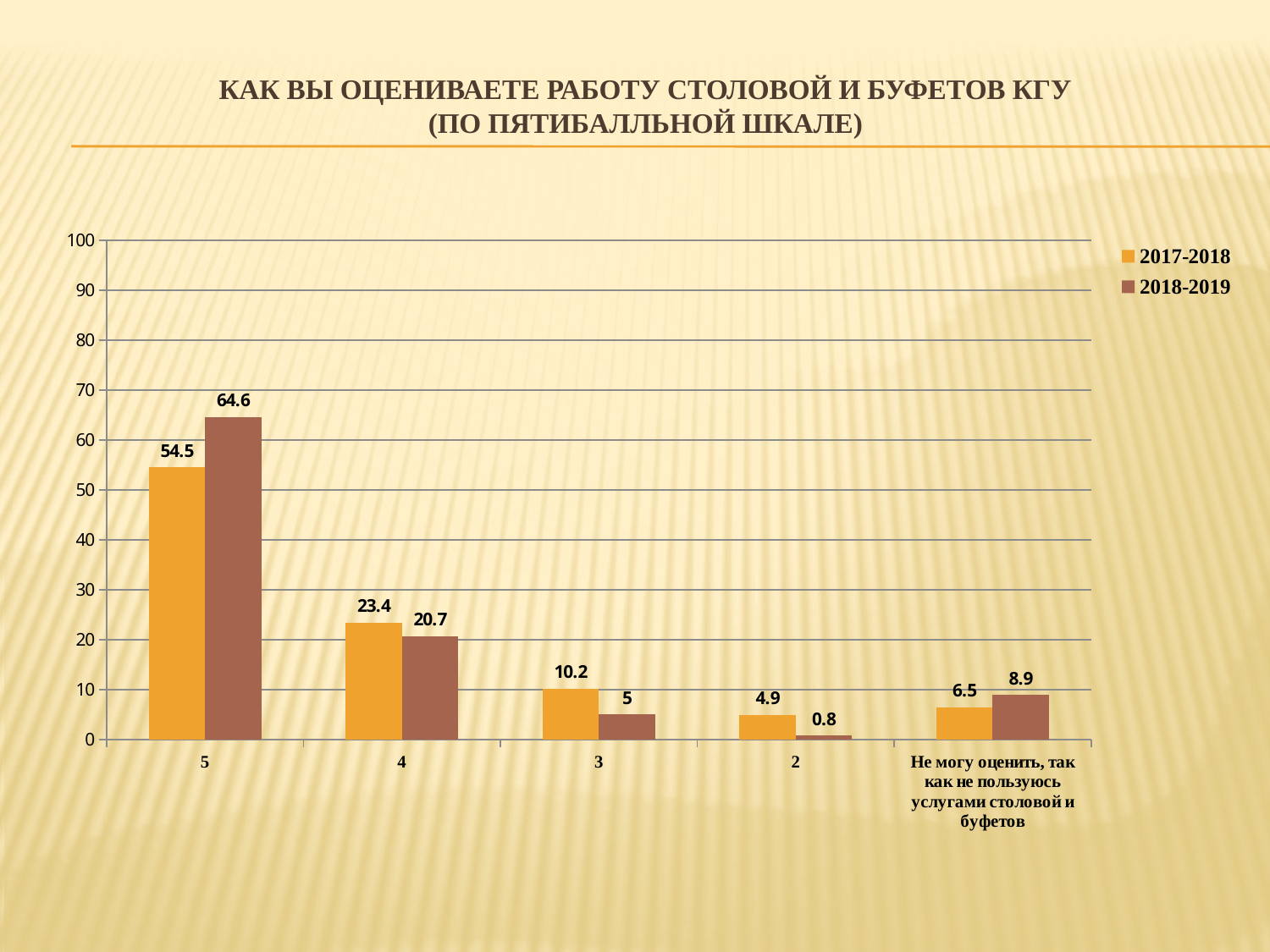
Which category has the highest value in the 2018-2019 series? 5 What kind of chart is shown on the slide? Bar chart Which category has the lowest value in the 2017-2018 series? 2 Which is larger for rating 4: the 2017-2018 value or the 2018-2019 value? 2017-2018 How many series does the legend list? 2 What is the value for rating 5 in the 2018-2019 series? 64.6 What is the value for rating 2 in the 2018-2019 series? 0.8 How many categories are shown on the x axis? 5 What is the value for the category 'Не могу оценить, так как не пользуюсь услугами столовой и буфетов' in the 2018-2019 series? 8.9 What is the difference between the 2018-2019 and 2017-2018 values for rating 5? 10.1 What is the value for rating 3 in the 2018-2019 series? 5 What is the value for rating 5 in the 2017-2018 series? 54.5